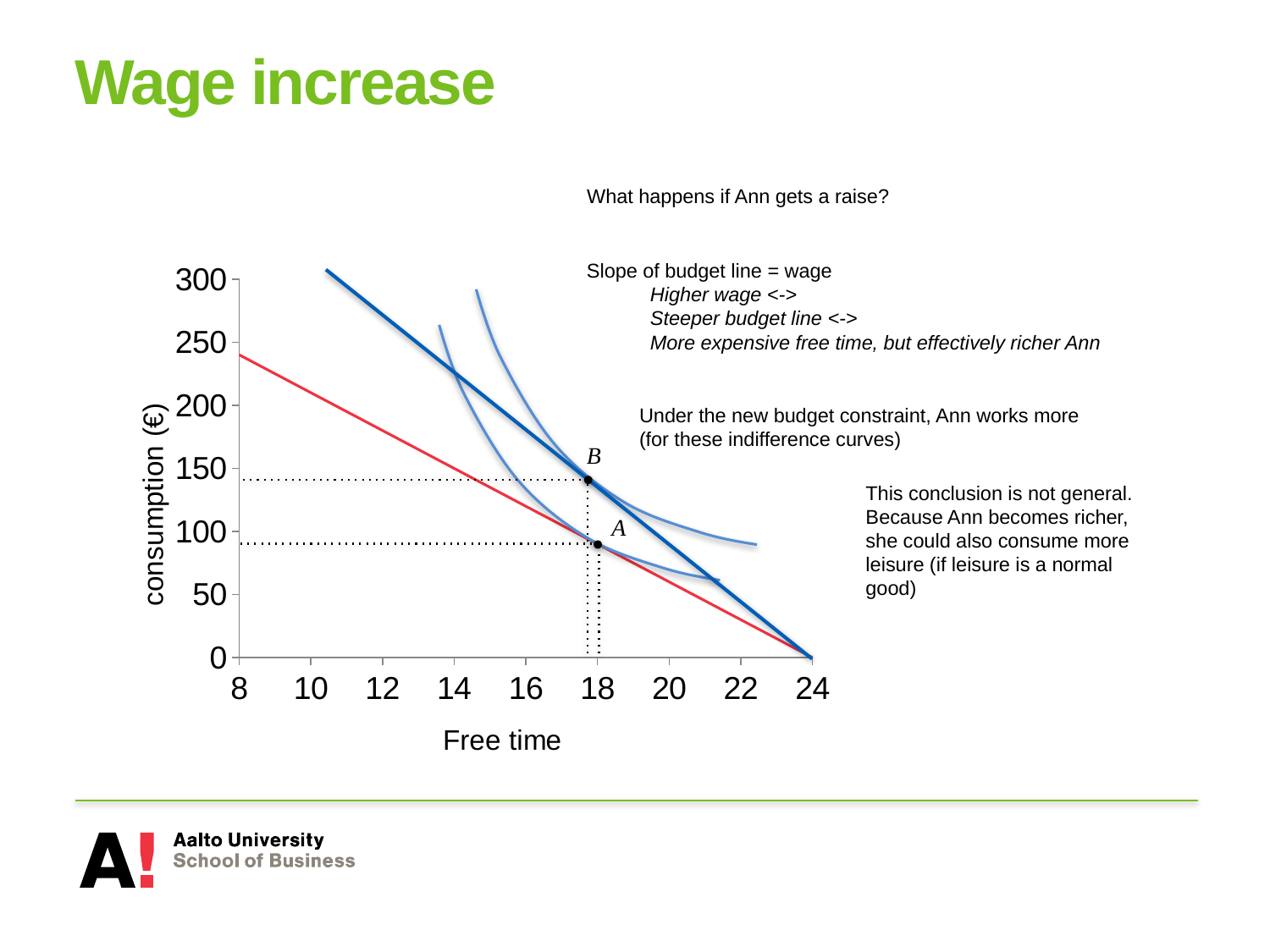
What is the label of the x axis? Free time What is the label of the y axis? consumption (€) Is the consumption at point A greater or less than 50? greater Is the consumption at point A greater or less than 100? less Is the consumption on the red budget line at free time 8 greater or less than 200? greater How many labelled points are marked on the chart? 2 What kind of chart is shown on the slide? line chart Do the budget lines rise or fall as free time increases? fall At what value of free time do both budget lines meet the x axis? 24 Which point has the higher consumption, A or B? B